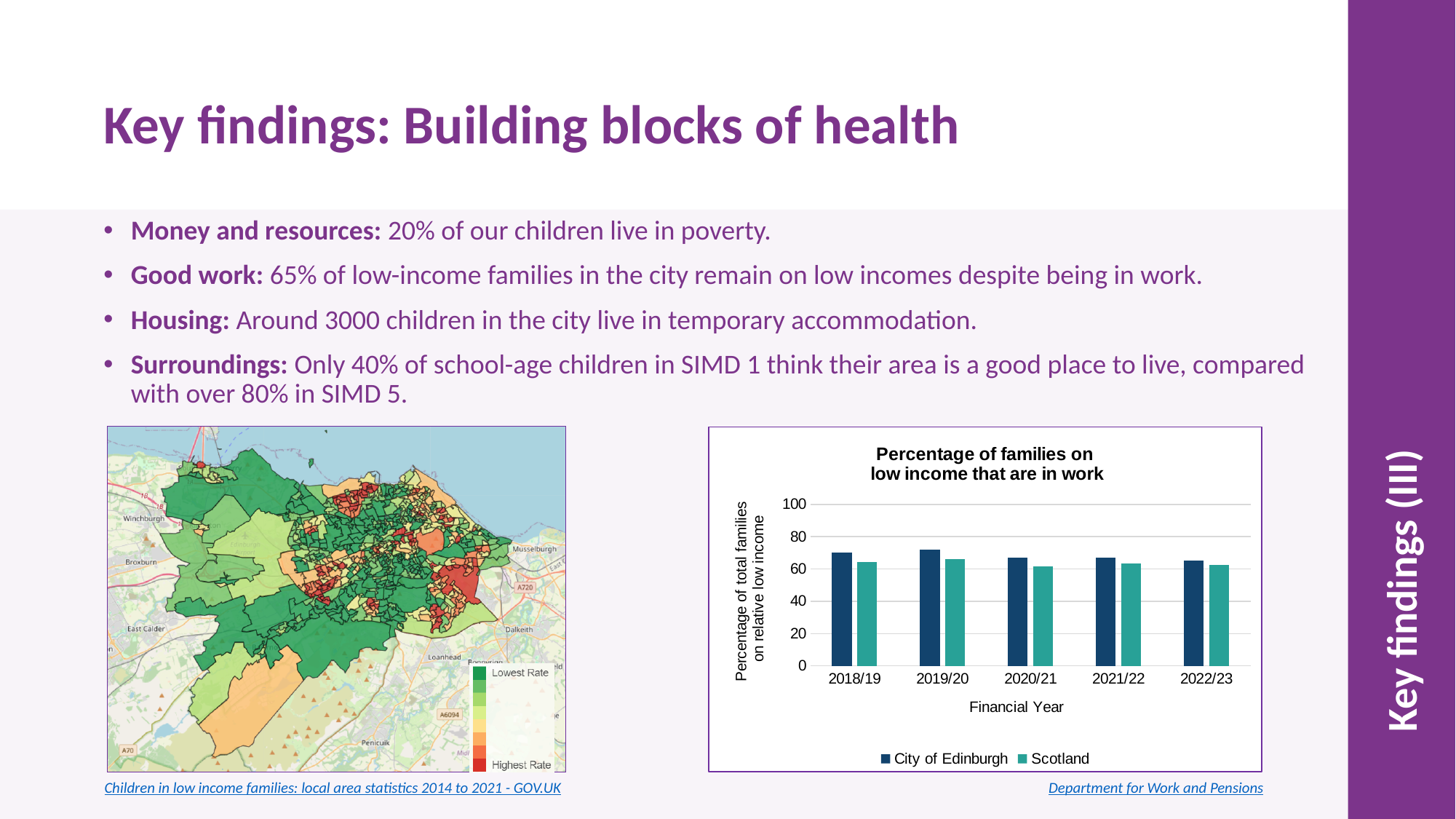
In the bar chart, which is larger in 2018/19: City of Edinburgh or Scotland? City of Edinburgh In the bar chart, is the value for City of Edinburgh in 2019/20 greater or less than 80? less In the bar chart, is the value for Scotland in 2020/21 greater or less than 80? less What is the title of the bar chart? Percentage of families on low income that are in work What kind of chart is shown on the right of the slide? Bar chart In the bar chart, is the City of Edinburgh value larger in 2019/20 or in 2022/23? 2019/20 In the bar chart, is the value for City of Edinburgh in 2018/19 greater or less than 60? greater How many series does the legend of the bar chart list? 2 Which two series are listed in the legend of the bar chart? City of Edinburgh and Scotland In the bar chart, do the City of Edinburgh values rise or fall from 2019/20 to 2022/23? fall How many financial years are shown on the x axis of the bar chart? 5